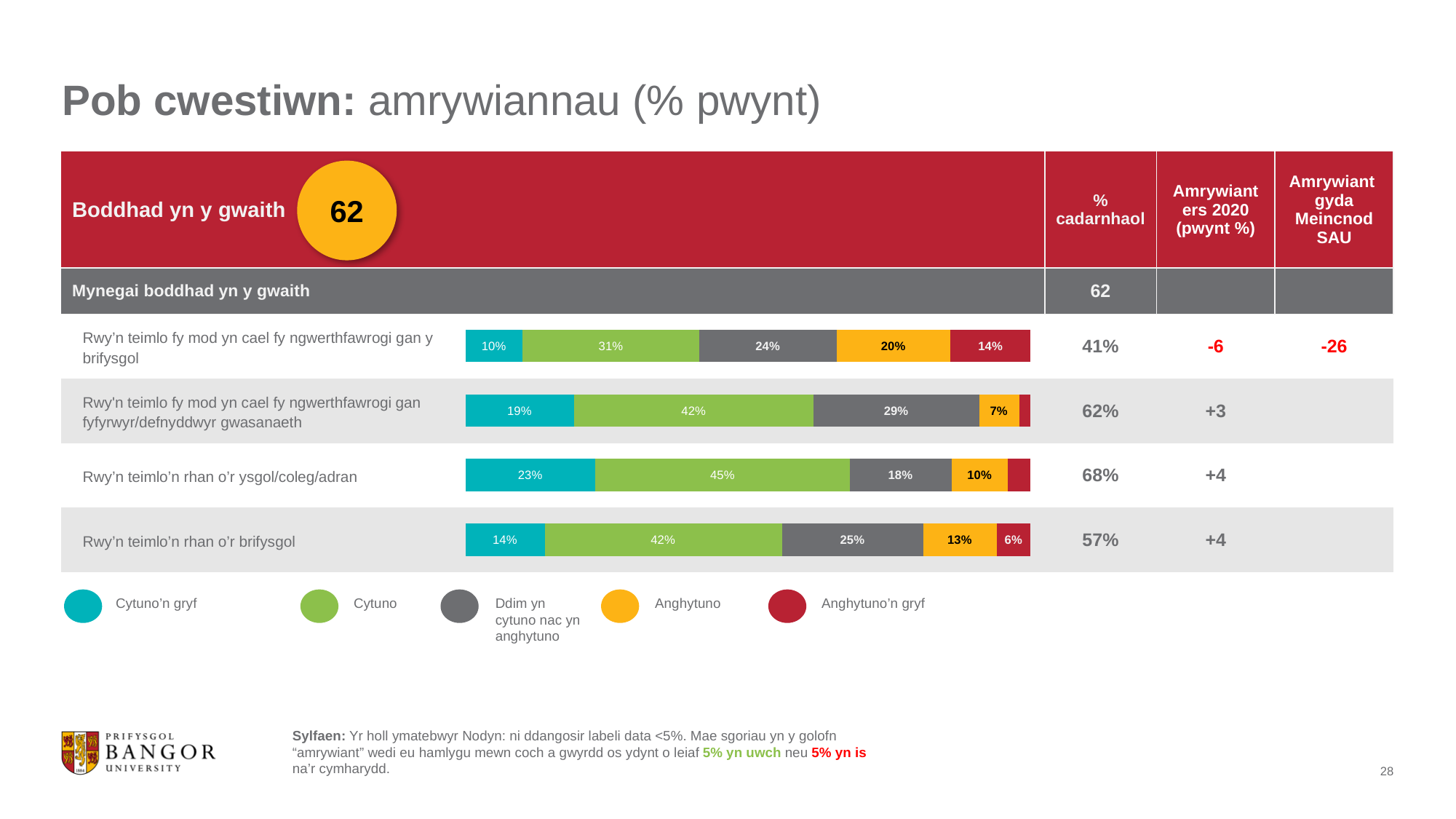
What is the 'Cytuno'n gryf' value for 'Rwy'n teimlo fy mod yn cael fy ngwerthfawrogi gan fyfyrwyr/defnyddwyr gwasanaeth'? 19% How many response categories does the legend list? 5 What is the 'Anghytuno'n gryf' value for 'Rwy'n teimlo fy mod yn cael fy ngwerthfawrogi gan y brifysgol'? 14% What is the difference between the 'Anghytuno' values for 'Rwy'n teimlo fy mod yn cael fy ngwerthfawrogi gan y brifysgol' and 'Rwy'n teimlo'n rhan o'r brifysgol'? 7% Which is larger: the 'Ddim yn cytuno nac yn anghytuno' value for 'Rwy'n teimlo fy mod yn cael fy ngwerthfawrogi gan fyfyrwyr/defnyddwyr gwasanaeth' or for 'Rwy'n teimlo'n rhan o'r ysgol/coleg/adran'? Rwy'n teimlo fy mod yn cael fy ngwerthfawrogi gan fyfyrwyr/defnyddwyr gwasanaeth How many statements (bars) are shown in the chart? 4 What is the 'Ddim yn cytuno nac yn anghytuno' value for 'Rwy'n teimlo'n rhan o'r brifysgol'? 25% What colour represents 'Anghytuno' in the legend? Orange/yellow What is the 'Cytuno' value for 'Rwy'n teimlo'n rhan o'r ysgol/coleg/adran'? 45% Which statement has the highest 'Cytuno'n gryf' value? Rwy'n teimlo'n rhan o'r ysgol/coleg/adran Which statement has the lowest 'Cytuno' value? Rwy'n teimlo fy mod yn cael fy ngwerthfawrogi gan y brifysgol What kind of chart is used to show the responses for each statement? Stacked bar chart